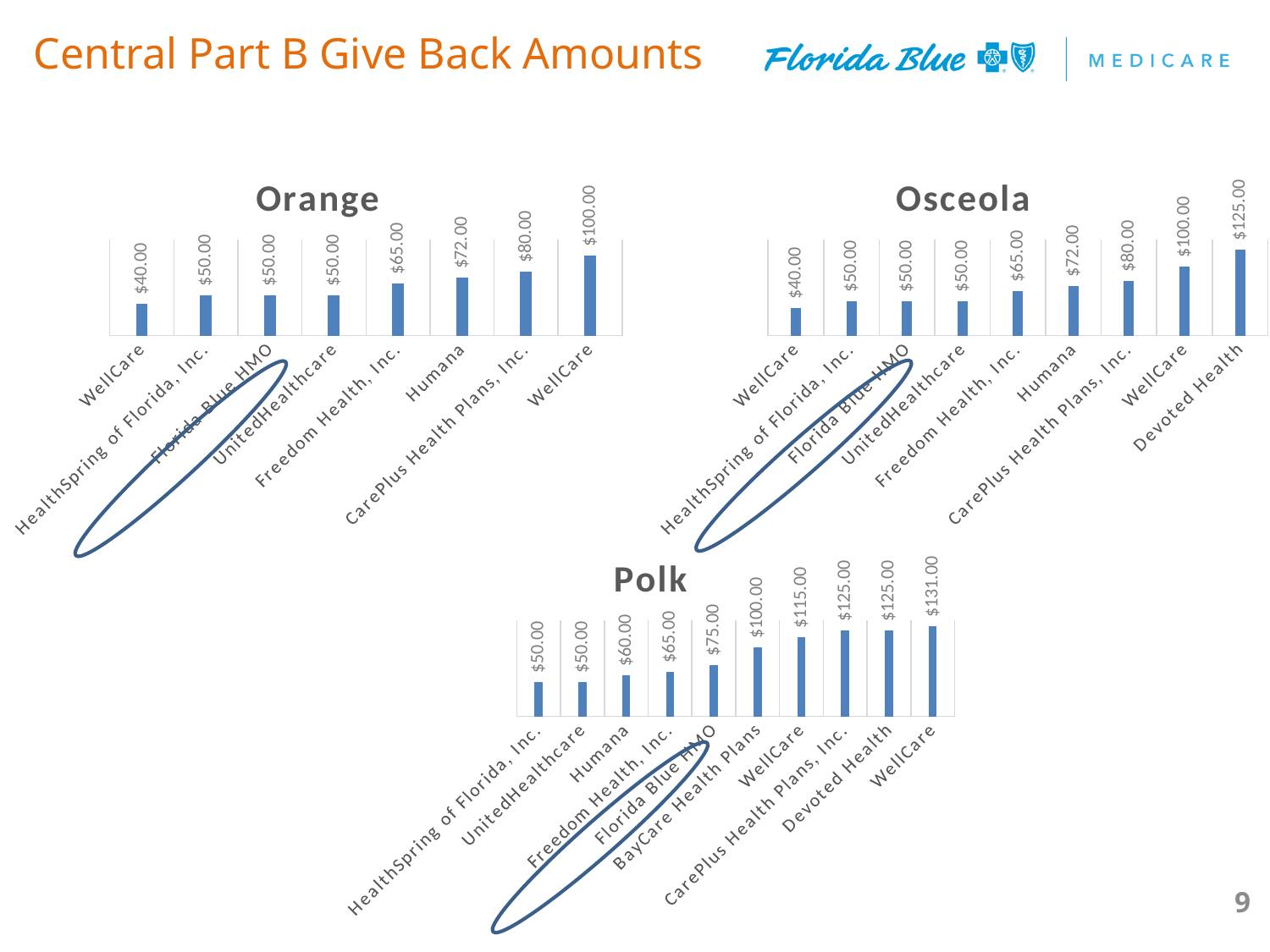
In the Polk chart, what is the value for BayCare Health Plans? $100.00 In the Polk chart, which category has the highest value? WellCare In the Osceola chart, which category has the highest value? Devoted Health How many bars are in the Osceola chart? 9 In the Osceola chart, what is the value for Devoted Health? $125.00 In the Orange chart, what is the difference between the values for CarePlus Health Plans, Inc. and Freedom Health, Inc.? $15.00 In the Polk chart, which is larger, the value for Humana or the value for Freedom Health, Inc.? Freedom Health, Inc. In the Polk chart, what is the value for Florida Blue HMO? $75.00 How many bars are in the Polk chart? 10 What type of chart is the Orange chart? Bar chart In the Orange chart, what is the value for Humana? $72.00 In the Orange chart, which category has the lowest value? WellCare